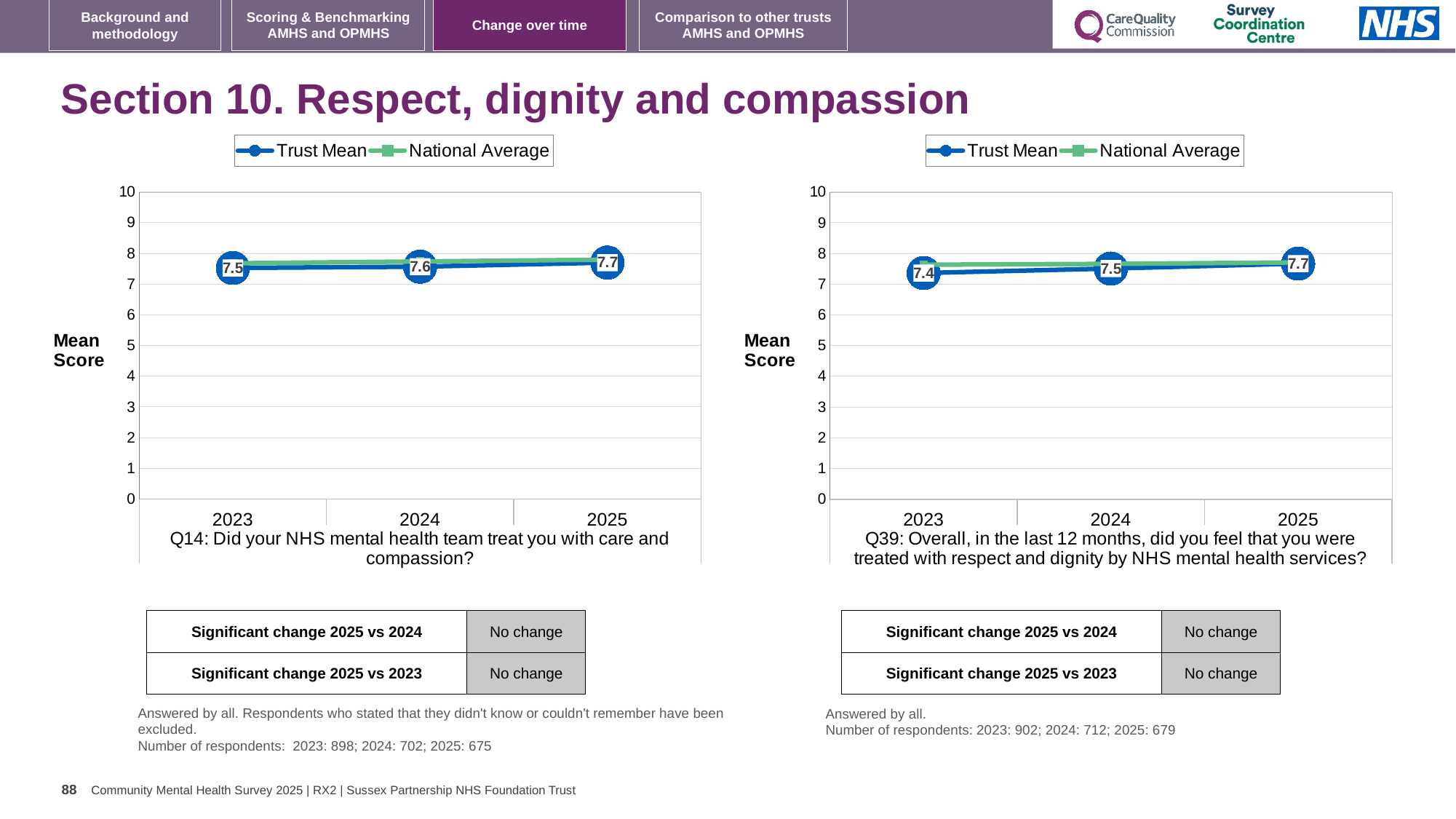
In the Q39 chart (right), what is the Trust Mean for 2023? 7.4 In the Q39 chart (right), what is the Trust Mean for 2024? 7.5 In the Q14 chart (left), does the Trust Mean rise or fall from 2023 to 2025? rise In the Q14 chart (left), what is the Trust Mean for 2023? 7.5 In the Q39 chart (right), what is the difference between the Trust Mean for 2025 and 2023? 0.3 What type of chart is the Q39 chart (right)? line chart In the Q14 chart (left), is the Trust Mean for 2024 greater or less than 5? greater In the Q39 chart (right), which year has the lowest Trust Mean? 2023 In the Q14 chart (left), which year has the highest Trust Mean? 2025 In the Q14 chart (left), what is the Trust Mean for 2025? 7.7 How many series does the legend of the Q14 chart (left) list? 2 How many years are shown on the x axis of the Q39 chart (right)? 3